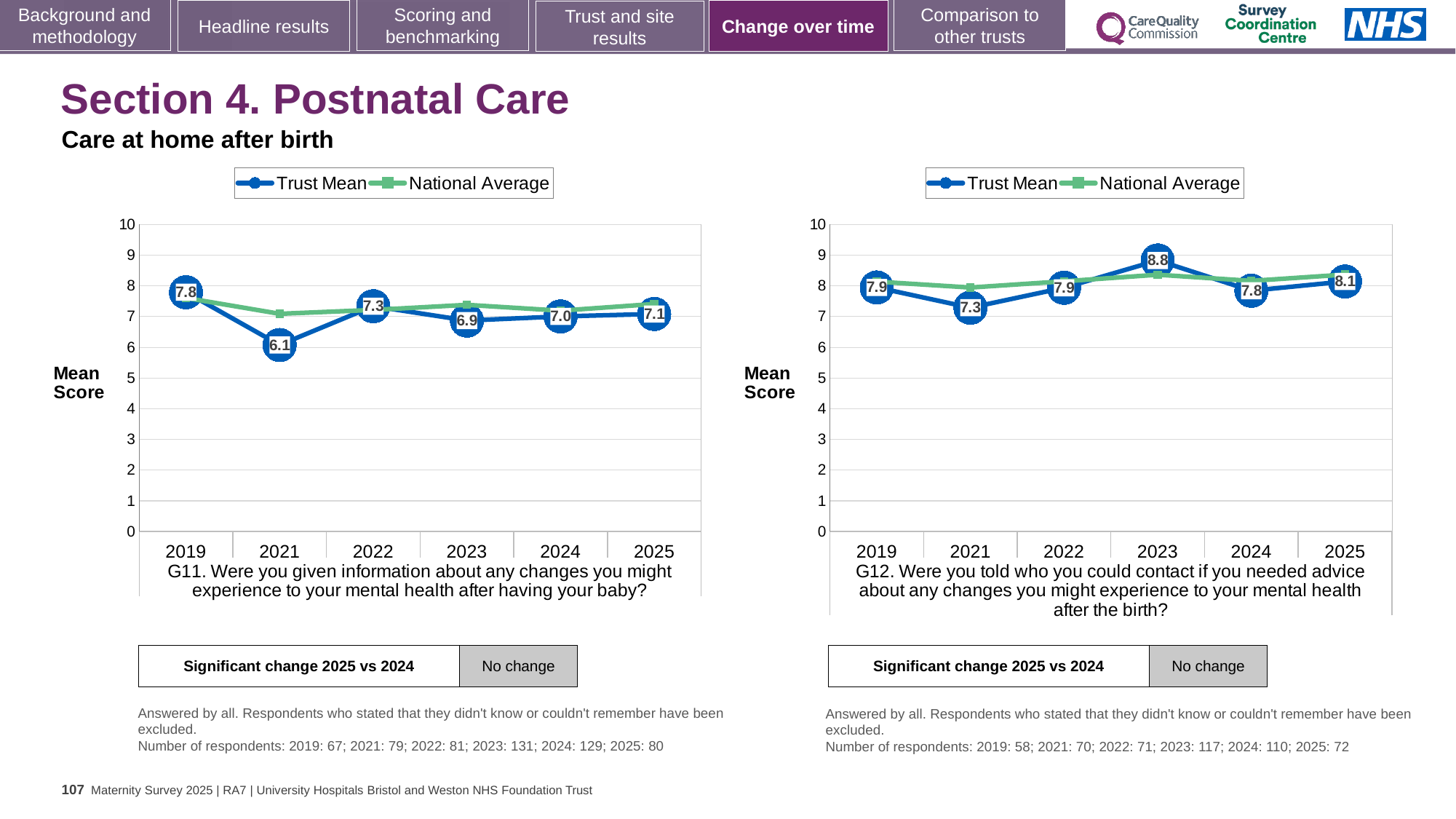
In the left chart (G11), what is the Trust Mean score for 2021? 6.1 In the right chart (G12), which year has the lowest Trust Mean score? 2021 In the right chart (G12), what is the Trust Mean score for 2023? 8.8 What type of chart is the right chart (G12)? Line chart In the right chart (G12), is the National Average for 2021 greater or less than 9? less In the left chart (G11), which year has the highest Trust Mean score? 2019 In the left chart (G11), what is the Trust Mean score for 2025? 7.1 In the right chart (G12), is the Trust Mean score for 2023 or 2025 larger? 2023 In the left chart (G11), which year has the lowest Trust Mean score? 2021 How many years are plotted on the x axis of the left chart (G11)? 6 In the left chart (G11), what is the difference between the Trust Mean scores for 2019 and 2021? 1.7 In the right chart (G12), what is the Trust Mean score for 2024? 7.8